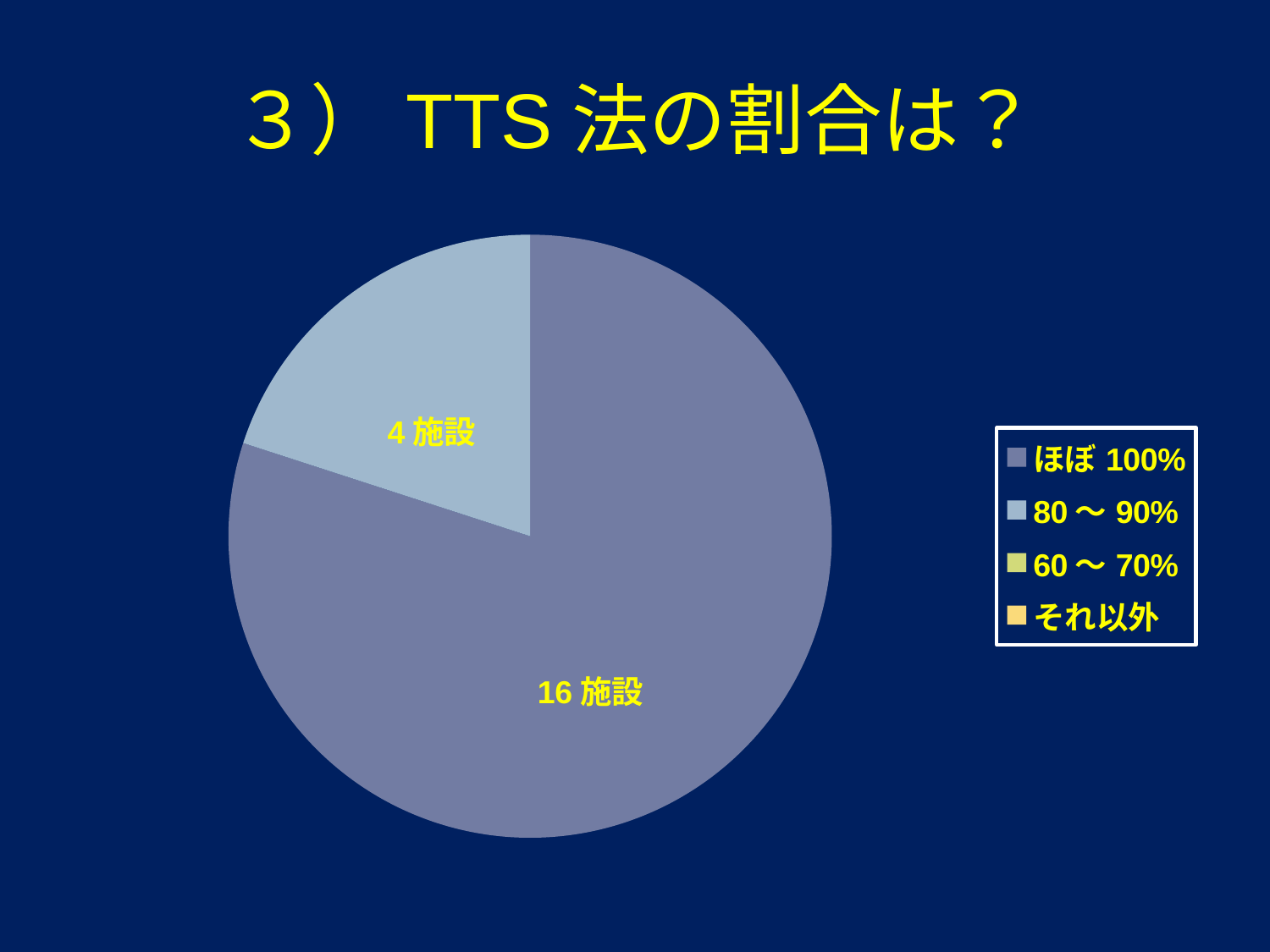
Which legend category corresponds to the largest slice of the pie? ほぼ 100% What is the value labelled on the largest slice of the pie chart? 16 施設 What share of the pie does the ほぼ 100% slice represent? 80% What is the total number of facilities shown across the pie slices? 20 施設 Which legend category corresponds to the slice labelled 4 施設? 80 ～ 90% How many entries does the legend list? 4 What kind of chart is shown on the slide? pie chart What is the title of the slide containing the chart? ３） TTS 法の割合は？ What is the difference between the number of facilities in the ほぼ 100% slice and the 80 ～ 90% slice? 12 施設 How many slices are visible in the pie chart? 2 Which slice is larger: ほぼ 100% or 80 ～ 90%? ほぼ 100% What is the value labelled on the smaller slice of the pie chart? 4 施設